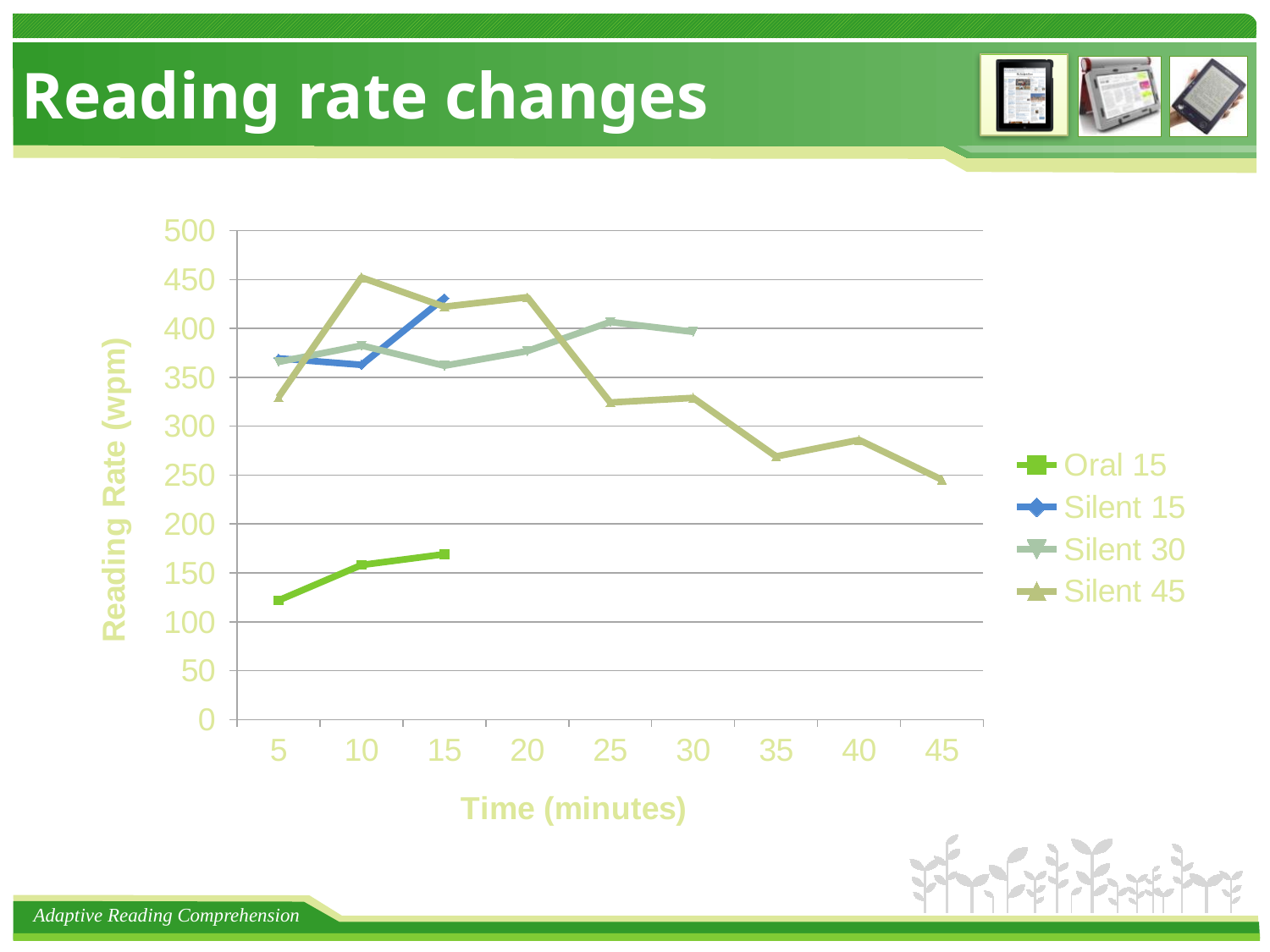
What is the title of the horizontal axis? Time (minutes) Which series has the lowest reading rates overall? Oral 15 Is the value for Oral 15 at 5 minutes greater or less than 150? less Is the value for Silent 45 at 45 minutes greater or less than 300? less How many series does the legend list? 4 What is the title of the vertical axis? Reading Rate (wpm) Does the Oral 15 line rise or fall from 5 to 15 minutes? rise Is the value for Silent 45 at 10 minutes greater or less than 400? greater At 25 minutes, which series has the larger value: Silent 30 or Silent 45? Silent 30 What kind of chart is shown on the slide? line chart At 5 minutes, which series has the larger value: Oral 15 or Silent 45? Silent 45